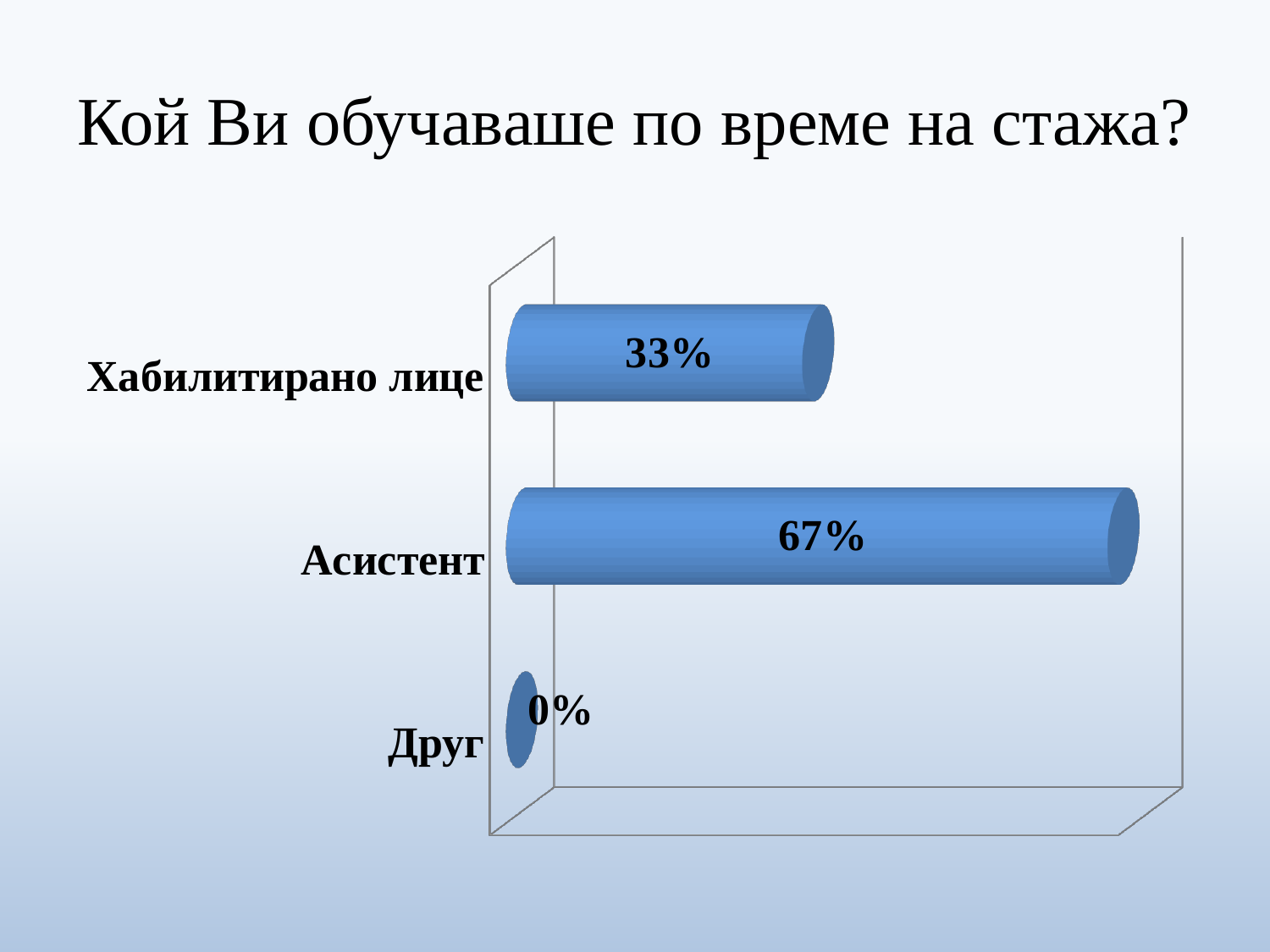
What is the value for Друг? 0% What is the difference between the values for Асистент and Хабилитирано лице? 34% What is the title of the slide? Кой Ви обучаваше по време на стажа? Which category has the lowest value? Друг What is the value for Асистент? 67% How many categories are shown in the chart? 3 Which category has the highest value? Асистент Which is larger, the value for Хабилитирано лице or the value for Асистент? Асистент What kind of chart is shown on the slide? Bar chart What colour are the bars in the chart? Blue What is the value for Хабилитирано лице? 33% What is the difference between the values for Хабилитирано лице and Друг? 33%